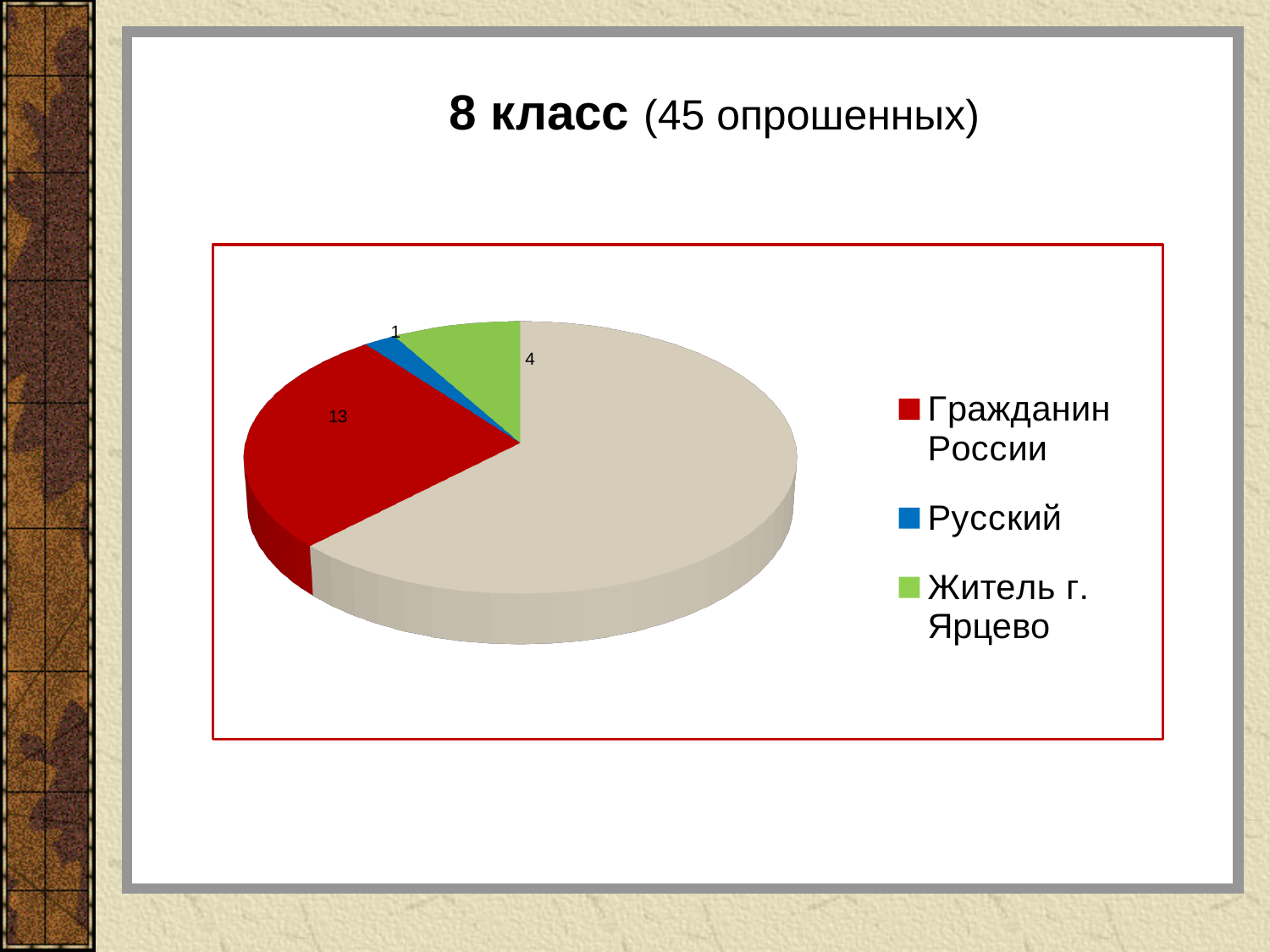
What colour is the slice for "Русский"? Blue How many categories does the legend list? 3 Which is larger, the value for "Гражданин России" or the value for "Житель г. Ярцево"? Гражданин России What value is shown for the slice "Гражданин России"? 13 What is the title of the slide above the chart? 8 класс (45 опрошенных) Among the categories listed in the legend, which has the smallest value? Русский What is the difference between the values for "Житель г. Ярцево" and "Русский"? 3 What is the difference between the values for "Гражданин России" and "Житель г. Ярцево"? 9 What kind of chart is shown on the slide? Pie chart What value is shown for the slice "Русский"? 1 What value is shown for the slice "Житель г. Ярцево"? 4 Among the categories listed in the legend, which has the largest value? Гражданин России